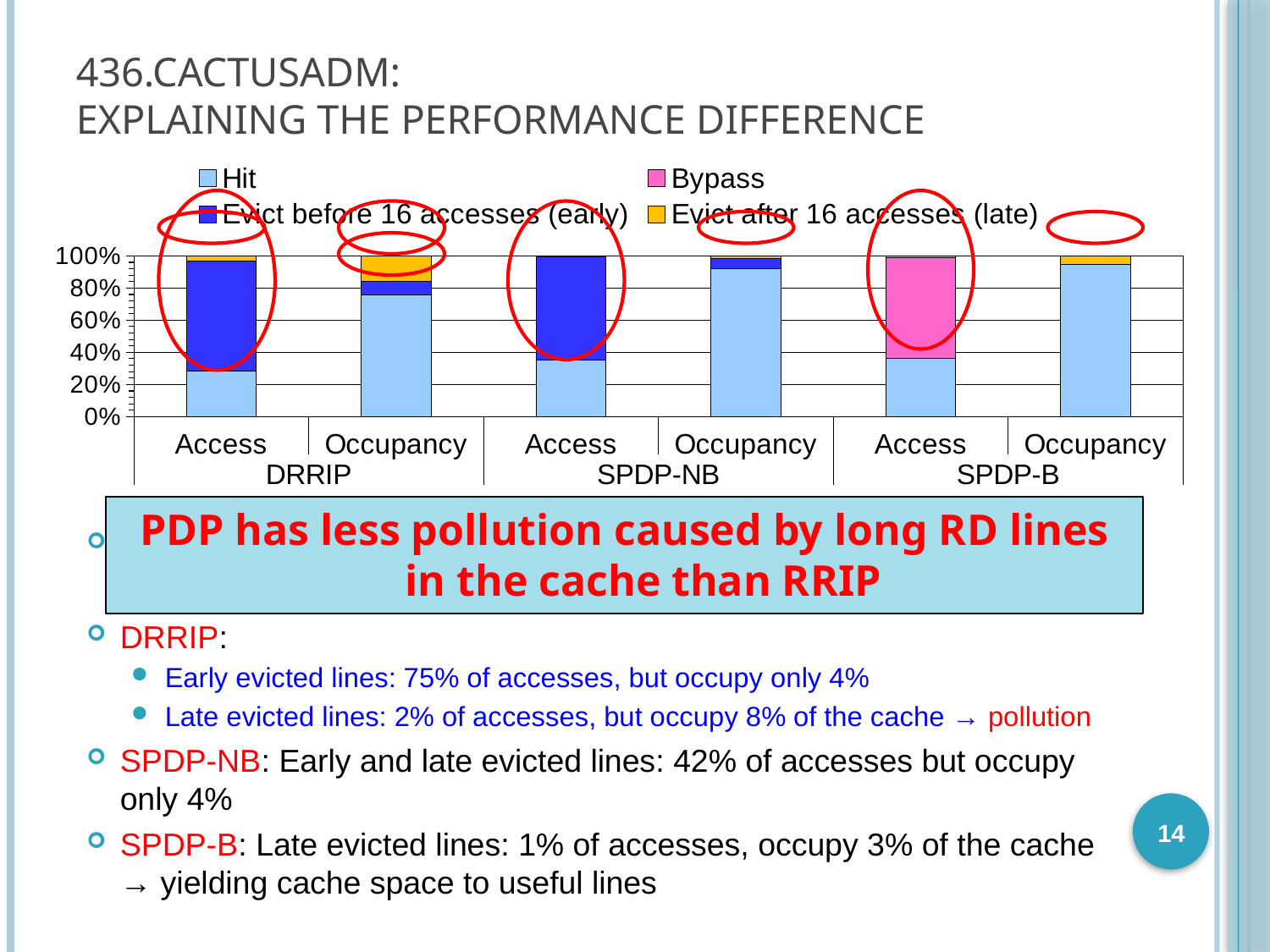
Which has the larger Hit share: the DRRIP Access bar or the DRRIP Occupancy bar? DRRIP Occupancy How many series does the chart legend list? 4 How many bars are plotted in the chart? 6 Which bar in the chart contains a Bypass segment? SPDP-B Access Is the Hit share of the SPDP-B Access bar greater or less than 60%? less What kind of chart is shown on the slide? Stacked bar chart Is the Hit share of the SPDP-B Occupancy bar greater or less than 80%? greater Is the Hit share of the DRRIP Occupancy bar greater or less than 60%? greater Which has the larger 'Evict before 16 accesses (early)' share: the DRRIP Access bar or the DRRIP Occupancy bar? DRRIP Access Which three policies are labelled along the x axis of the chart? DRRIP, SPDP-NB, SPDP-B